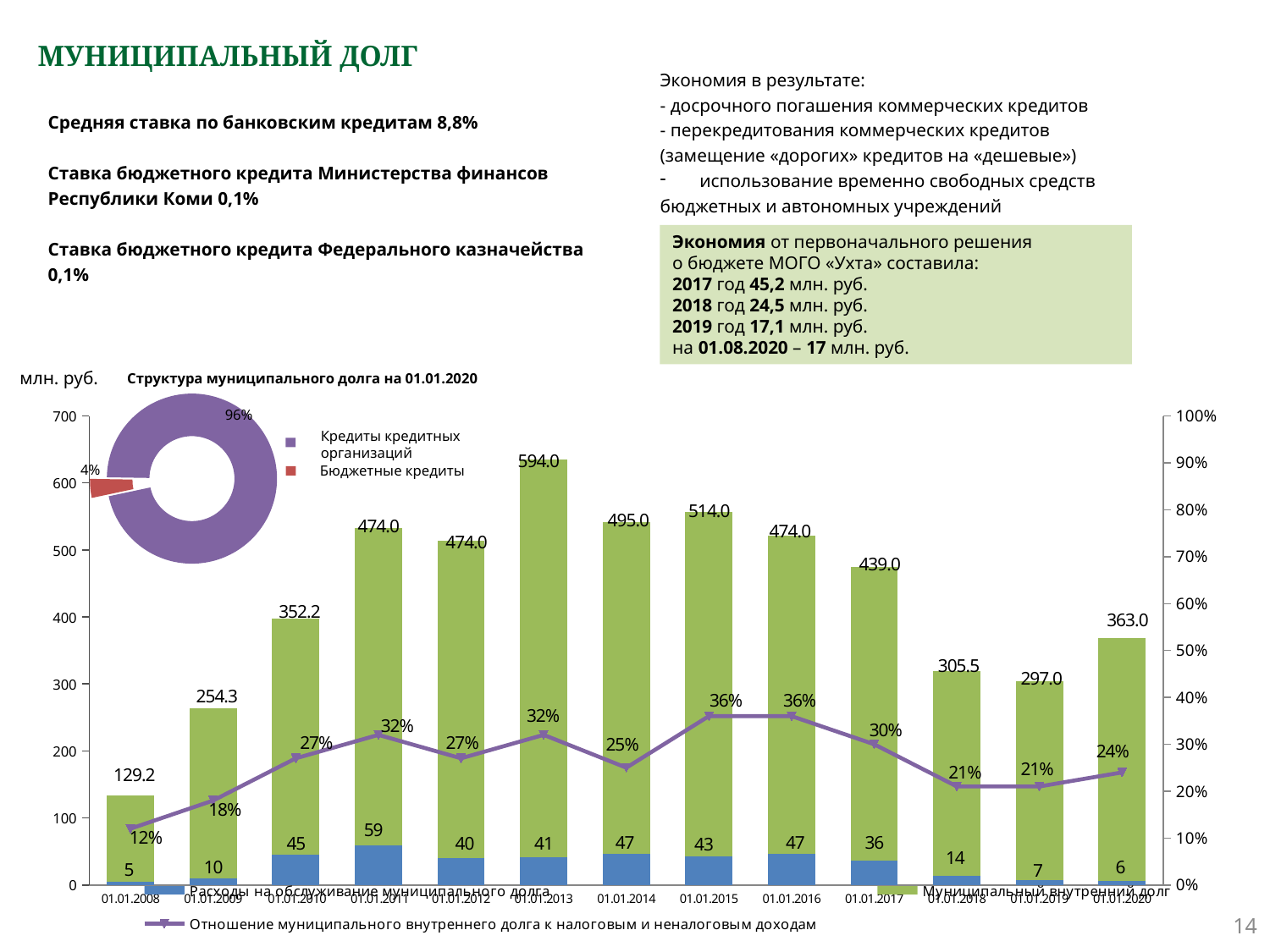
On the main bar chart, what is the value of the 'Муниципальный внутренний долг' bar for 01.01.2013? 594.0 In the donut chart 'Структура муниципального долга на 01.01.2020', what share is 'Кредиты кредитных организаций'? 96% On the main bar chart, how many series does the legend list? 3 On the main bar chart, what is the value of 'Расходы на обслуживание муниципального долга' for 01.01.2011? 59 On the main bar chart, how many dates are shown on the x axis? 13 On the main bar chart, which date has the highest 'Муниципальный внутренний долг' value? 01.01.2013 On the main bar chart, what is the value of the 'Муниципальный внутренний долг' bar for 01.01.2020? 363.0 On the main bar chart, which date has the lowest 'Муниципальный внутренний долг' value? 01.01.2008 In the donut chart 'Структура муниципального долга на 01.01.2020', what share is 'Бюджетные кредиты'? 4% On the main bar chart, what is the difference between the 'Муниципальный внутренний долг' values for 01.01.2013 and 01.01.2020? 231.0 On the main bar chart, which is larger: 'Расходы на обслуживание муниципального долга' for 01.01.2010 or for 01.01.2018? 01.01.2010 On the main bar chart, what is the value of the line 'Отношение муниципального внутреннего долга к налоговым и неналоговым доходам' for 01.01.2015? 36%